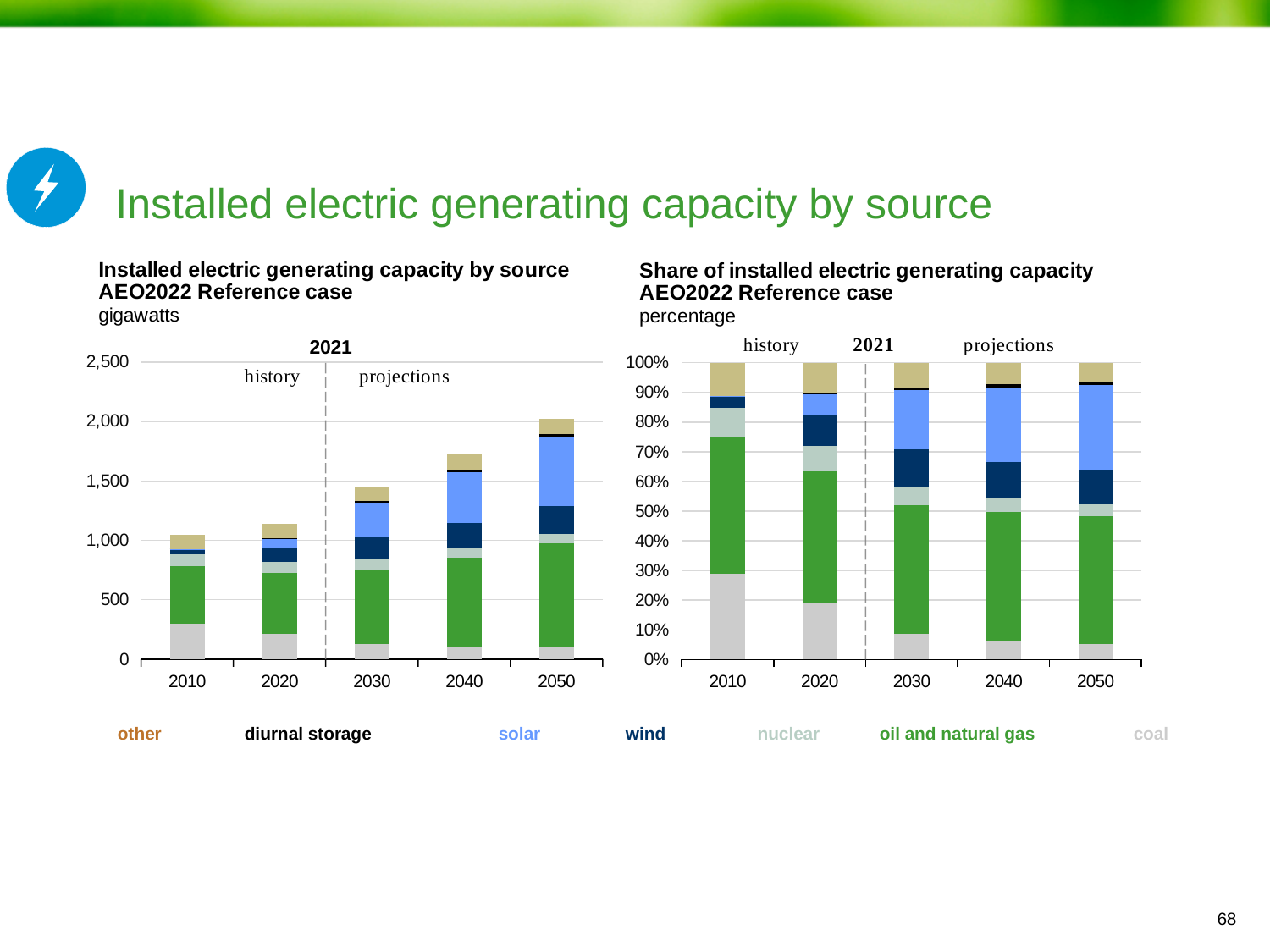
How many years are shown on the x axis of the left chart, 'Installed electric generating capacity by source'? 5 In the left chart, 'Installed electric generating capacity by source', which year has the lowest total installed capacity? 2010 What unit is shown under the title of the left chart? gigawatts What kind of chart is the left chart, 'Installed electric generating capacity by source'? stacked bar chart In the left chart, 'Installed electric generating capacity by source', is the total capacity for 2010 greater or less than 1,500 gigawatts? less In the left chart, 'Installed electric generating capacity by source', is the total capacity for 2040 greater or less than 2,000 gigawatts? less In the left chart, 'Installed electric generating capacity by source', is the total capacity for 2050 greater or less than 1,500 gigawatts? greater In the left chart, 'Installed electric generating capacity by source', which year has the highest total installed capacity? 2050 How many series does the shared legend list? 7 In the left chart, 'Installed electric generating capacity by source', does total installed capacity rise or fall from 2010 to 2050? rise